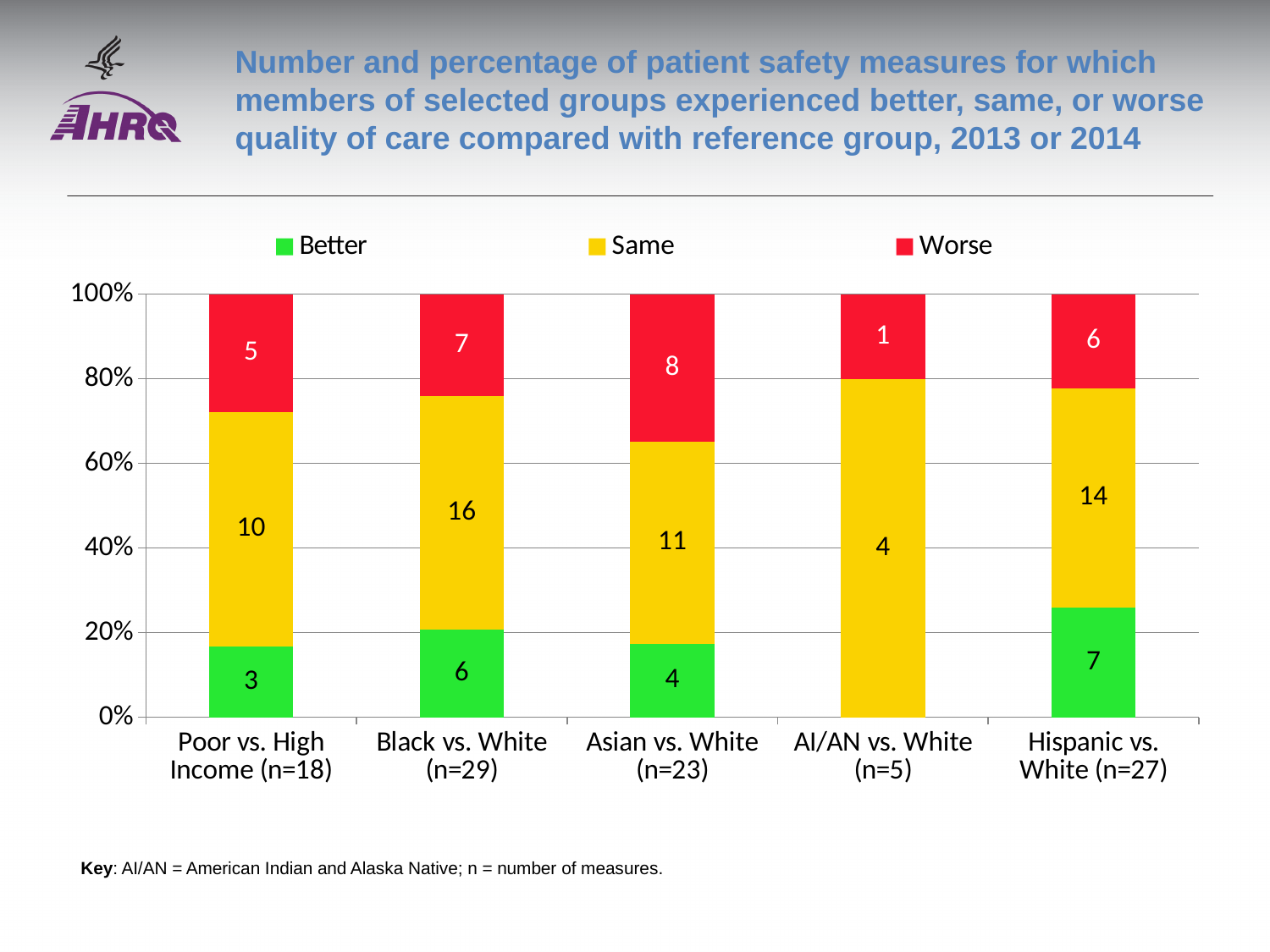
Which is larger: the 'Better' value for Black vs. White (n=29) or for Asian vs. White (n=23)? Black vs. White (n=29) How many series does the legend list? 3 How many categories are shown on the x axis? 5 What kind of chart is shown on the slide? Stacked bar chart Which category has the lowest 'Same' value? AI/AN vs. White (n=5) Which colour represents the 'Worse' series in the legend? Red What is the difference between the 'Same' values for Hispanic vs. White (n=27) and Poor vs. High Income (n=18)? 4 What is the 'Worse' value for AI/AN vs. White (n=5)? 1 What is the 'Same' value for Black vs. White (n=29)? 16 Which category has the highest 'Worse' value? Asian vs. White (n=23) What is the 'Better' value for Hispanic vs. White (n=27)? 7 Is the 'Same' share of the bar for AI/AN vs. White (n=5) greater or less than 60%? greater